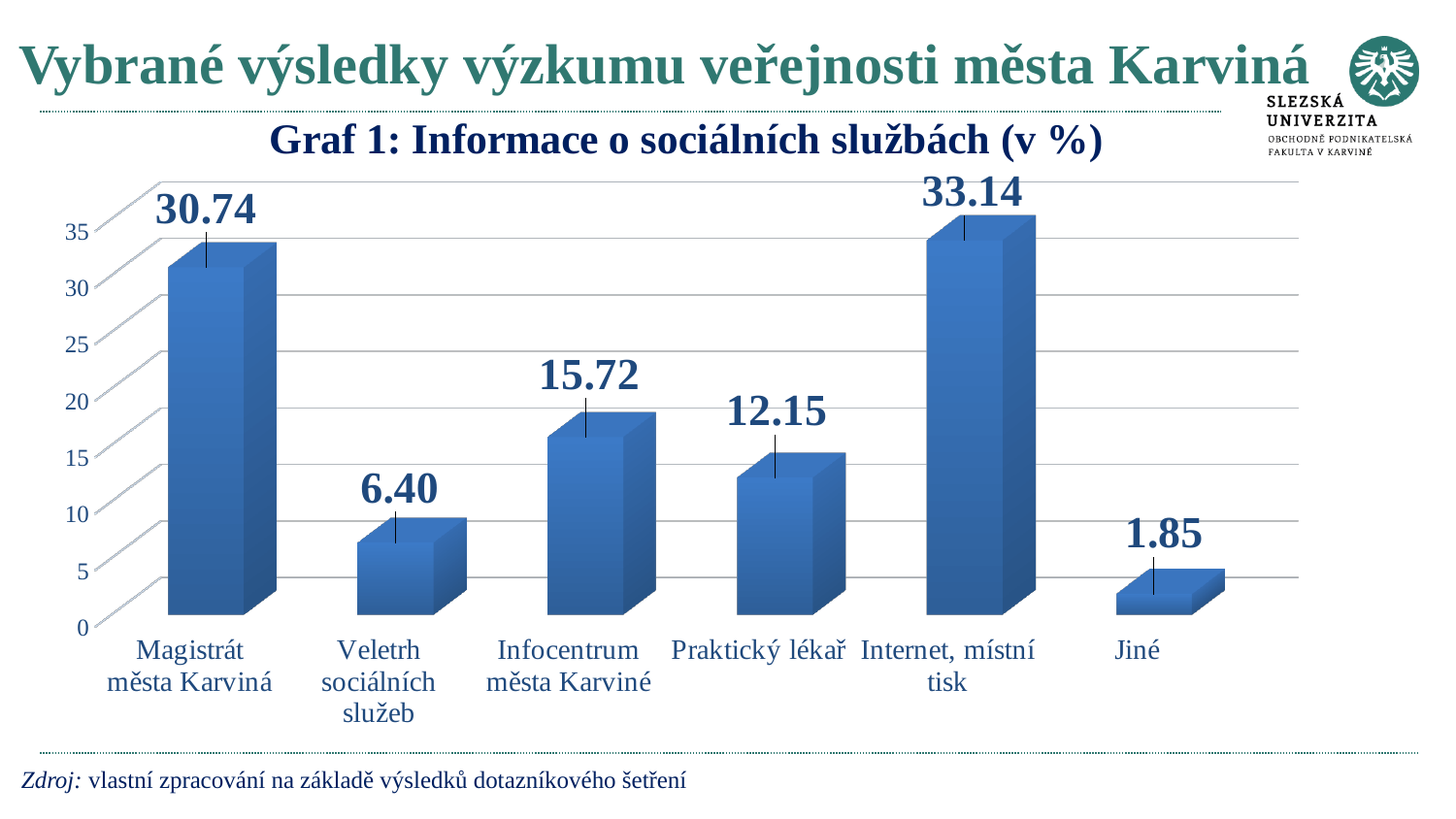
What is the value for Infocentrum města Karviné? 15.72 What is the value for Veletrh sociálních služeb? 6.40 What is the difference between the values for Internet, místní tisk and Magistrát města Karviná? 2.40 What is the value for Praktický lékař? 12.15 Is the value for Veletrh sociálních služeb greater or less than 10? less Which is larger, the value for Infocentrum města Karviné or the value for Praktický lékař? Infocentrum města Karviné What is the value for Magistrát města Karviná? 30.74 What kind of chart is shown on the slide? bar chart How many categories are shown in the chart? 6 Which category has the lowest value? Jiné Which category has the highest value? Internet, místní tisk What is the title of the chart? Graf 1: Informace o sociálních službách (v %)